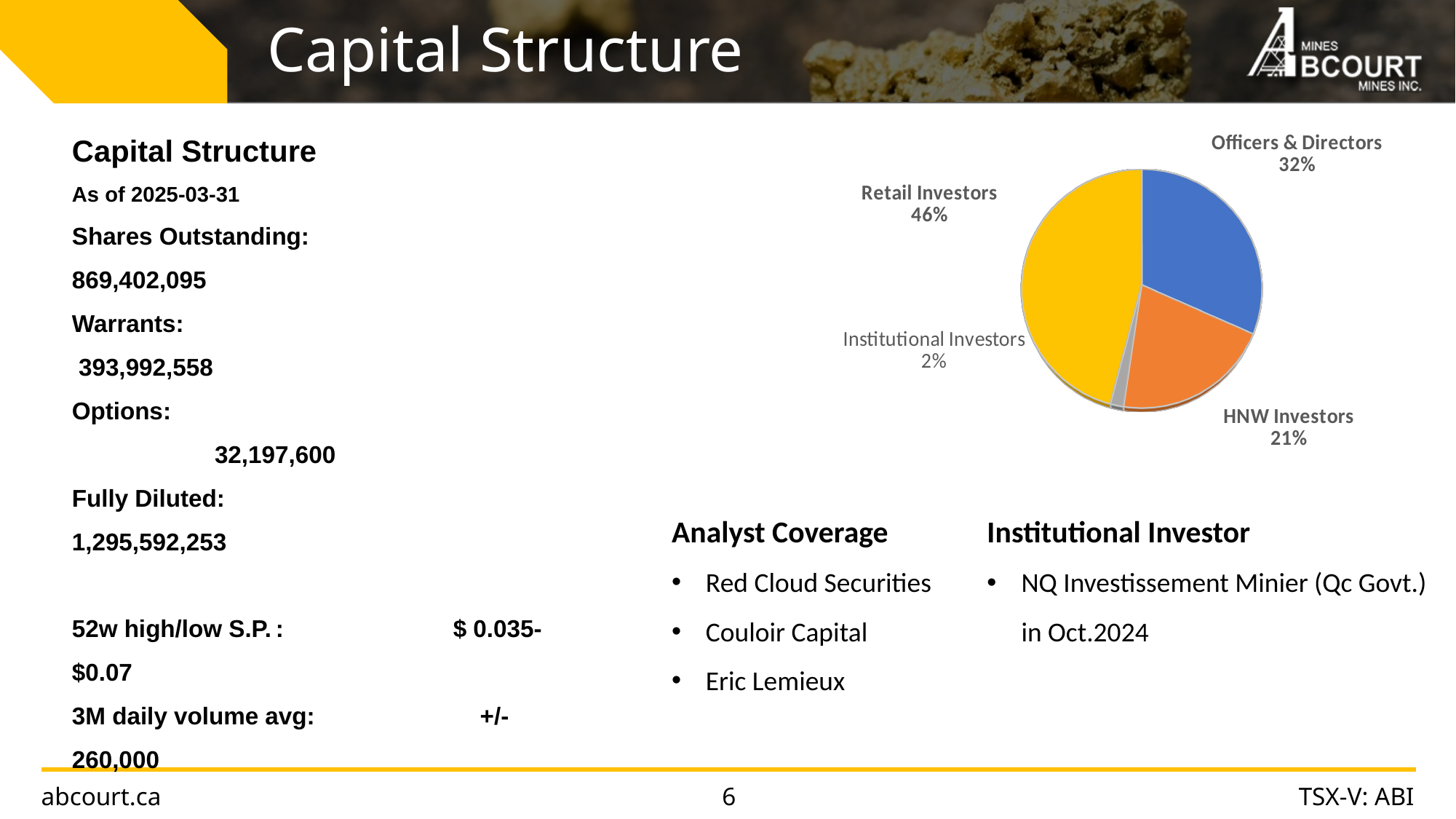
What share of the pie chart do Retail Investors hold? 46% What share of the pie chart do HNW Investors hold? 21% How many categories are shown in the pie chart? 4 What share of the pie chart do Institutional Investors hold? 2% What colour is the Retail Investors slice in the pie chart? yellow Which category has the smallest slice of the pie chart? Institutional Investors Which category has the largest slice of the pie chart? Retail Investors What kind of chart is shown on the slide? pie chart What colour is the HNW Investors slice in the pie chart? orange What share of the pie chart do Officers & Directors hold? 32% Which is larger in the pie chart, Officers & Directors or HNW Investors? Officers & Directors What is the difference in percentage points between Retail Investors and Officers & Directors? 14